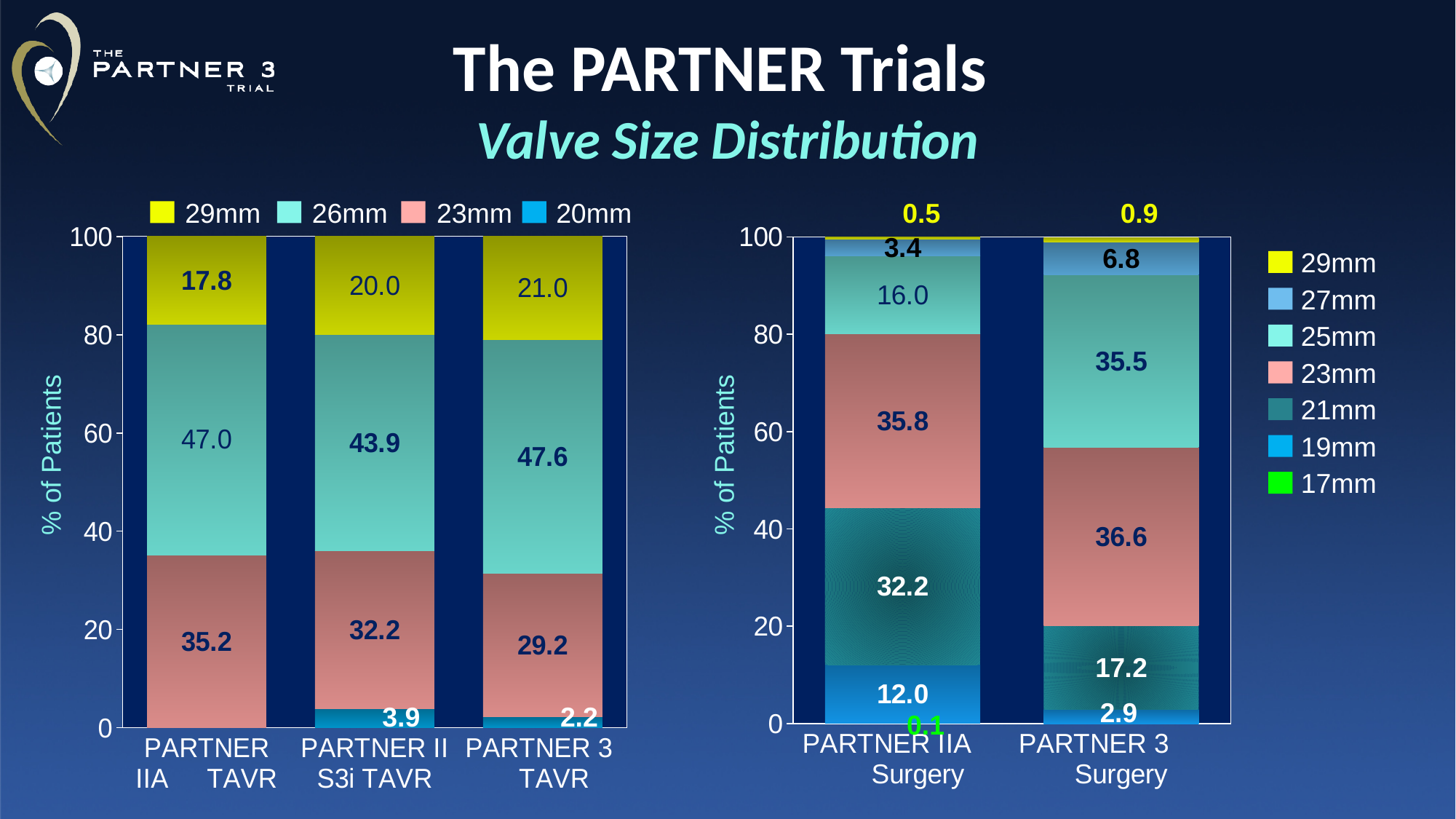
How many series does the legend of the right chart (Surgery) list? 7 In the left chart (TAVR), what is the value for 26mm in PARTNER 3 TAVR? 47.6 How many categories are shown on the x axis of the left chart (TAVR)? 3 In the right chart (Surgery), which valve size has the lowest value in PARTNER IIA Surgery? 17mm In the left chart (TAVR), what is the value for 29mm in PARTNER IIA TAVR? 17.8 In the right chart (Surgery), which is larger: the 25mm value for PARTNER 3 Surgery or the 25mm value for PARTNER IIA Surgery? PARTNER 3 Surgery What kind of chart is the right chart (Surgery)? Stacked bar chart In the left chart (TAVR), what is the difference between the 23mm values for PARTNER IIA TAVR and PARTNER 3 TAVR? 6.0 In the right chart (Surgery), what is the value for 27mm in PARTNER 3 Surgery? 6.8 In the left chart (TAVR), what is the value for 20mm in PARTNER II S3i TAVR? 3.9 In the right chart (Surgery), what is the value for 21mm in PARTNER IIA Surgery? 32.2 In the left chart (TAVR), which category has the highest value for 23mm? PARTNER IIA TAVR